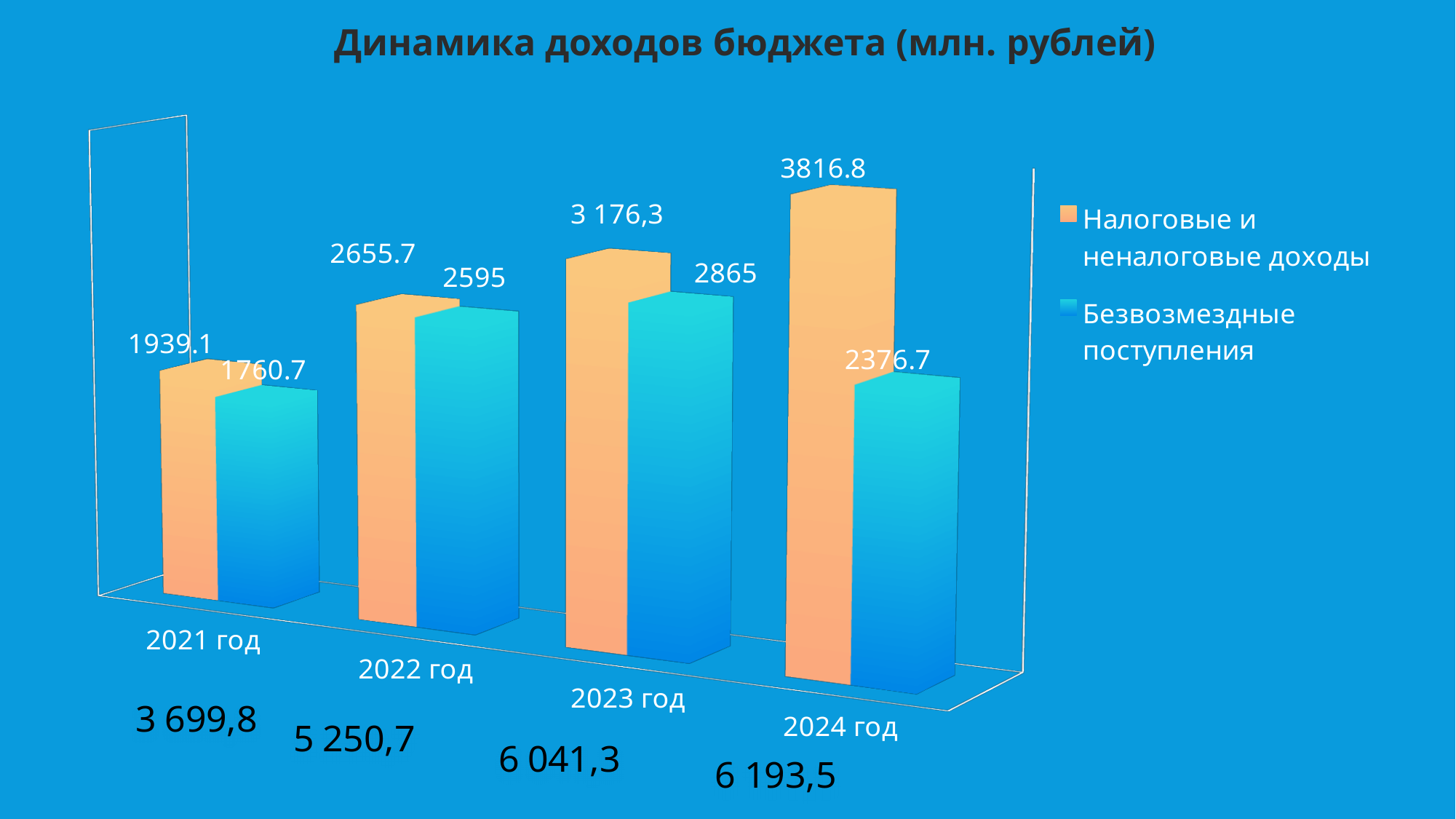
How many years are shown on the x axis? 4 What is the value of Налоговые и неналоговые доходы for 2021 год? 1939.1 How many series does the legend list? 2 What is the value of Безвозмездные поступления for 2023 год? 2865 What is the value of Налоговые и неналоговые доходы for 2023 год? 3 176,3 In which year is Налоговые и неналоговые доходы the highest? 2024 год Do the values of Налоговые и неналоговые доходы rise or fall from 2021 год to 2024 год? Rise In which year is Безвозмездные поступления the lowest? 2021 год What kind of chart is shown on the slide? Bar chart Which is larger in 2022 год: Налоговые и неналоговые доходы or Безвозмездные поступления? Налоговые и неналоговые доходы What is the value of Безвозмездные поступления for 2024 год? 2376.7 What is the difference between Налоговые и неналоговые доходы and Безвозмездные поступления in 2024 год? 1440.1